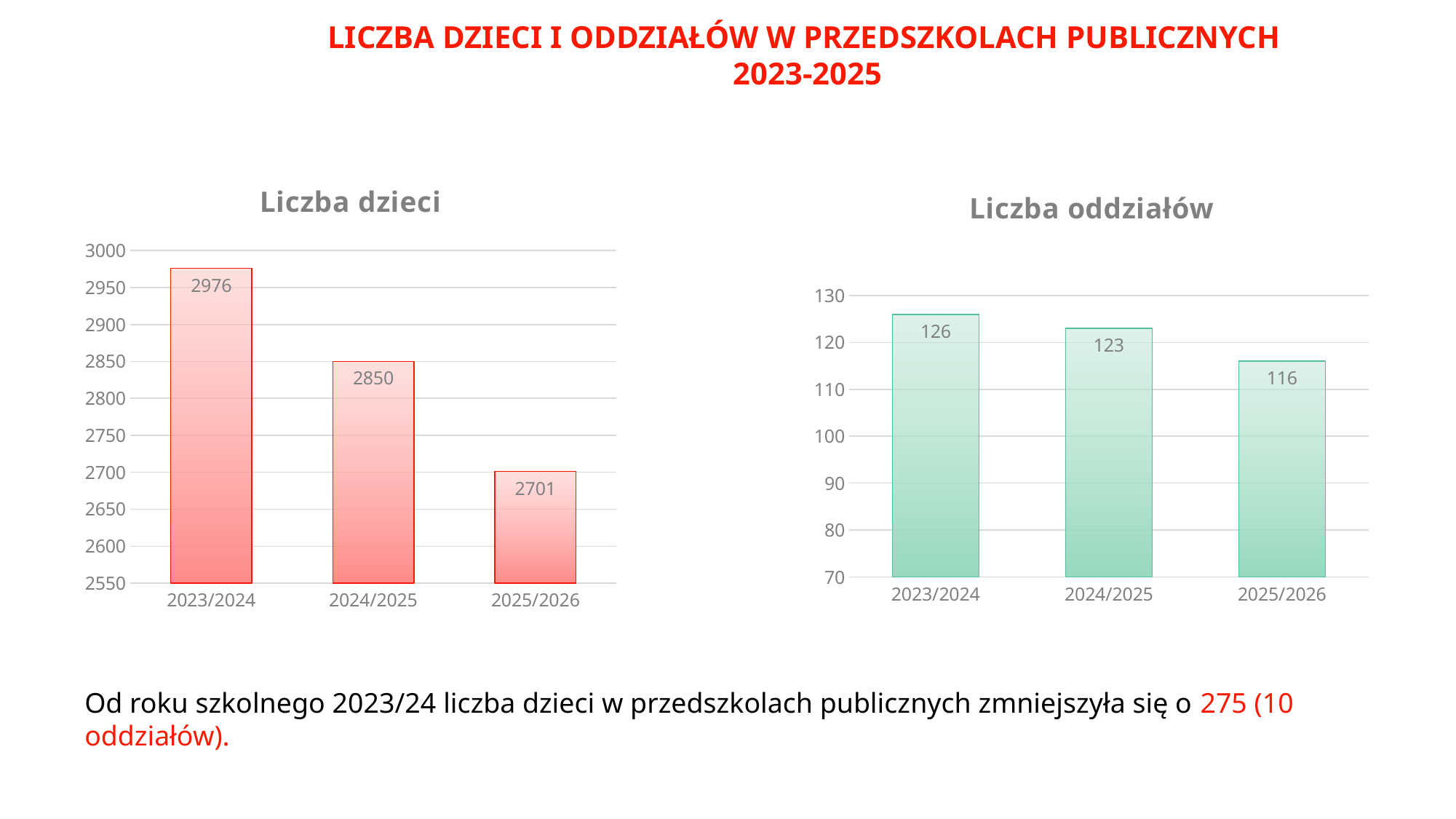
In the 'Liczba dzieci' chart, what is the value for 2023/2024? 2976 In the 'Liczba dzieci' chart, what is the difference between the values for 2023/2024 and 2025/2026? 275 In the 'Liczba dzieci' chart, which year has the highest value? 2023/2024 In the 'Liczba oddziałów' chart, which year has the lowest value? 2025/2026 In the 'Liczba dzieci' chart, what is the value for 2025/2026? 2701 In the 'Liczba dzieci' chart, which is larger: the value for 2024/2025 or the value for 2025/2026? 2024/2025 What kind of chart is the 'Liczba oddziałów' chart? bar chart In the 'Liczba oddziałów' chart, is the value for 2025/2026 greater or less than 120? less In the 'Liczba oddziałów' chart, what is the value for 2024/2025? 123 In the 'Liczba oddziałów' chart, what is the difference between the values for 2023/2024 and 2025/2026? 10 How many categories are shown in the 'Liczba dzieci' chart? 3 In the 'Liczba dzieci' chart, do the values rise or fall from 2023/2024 to 2025/2026? fall